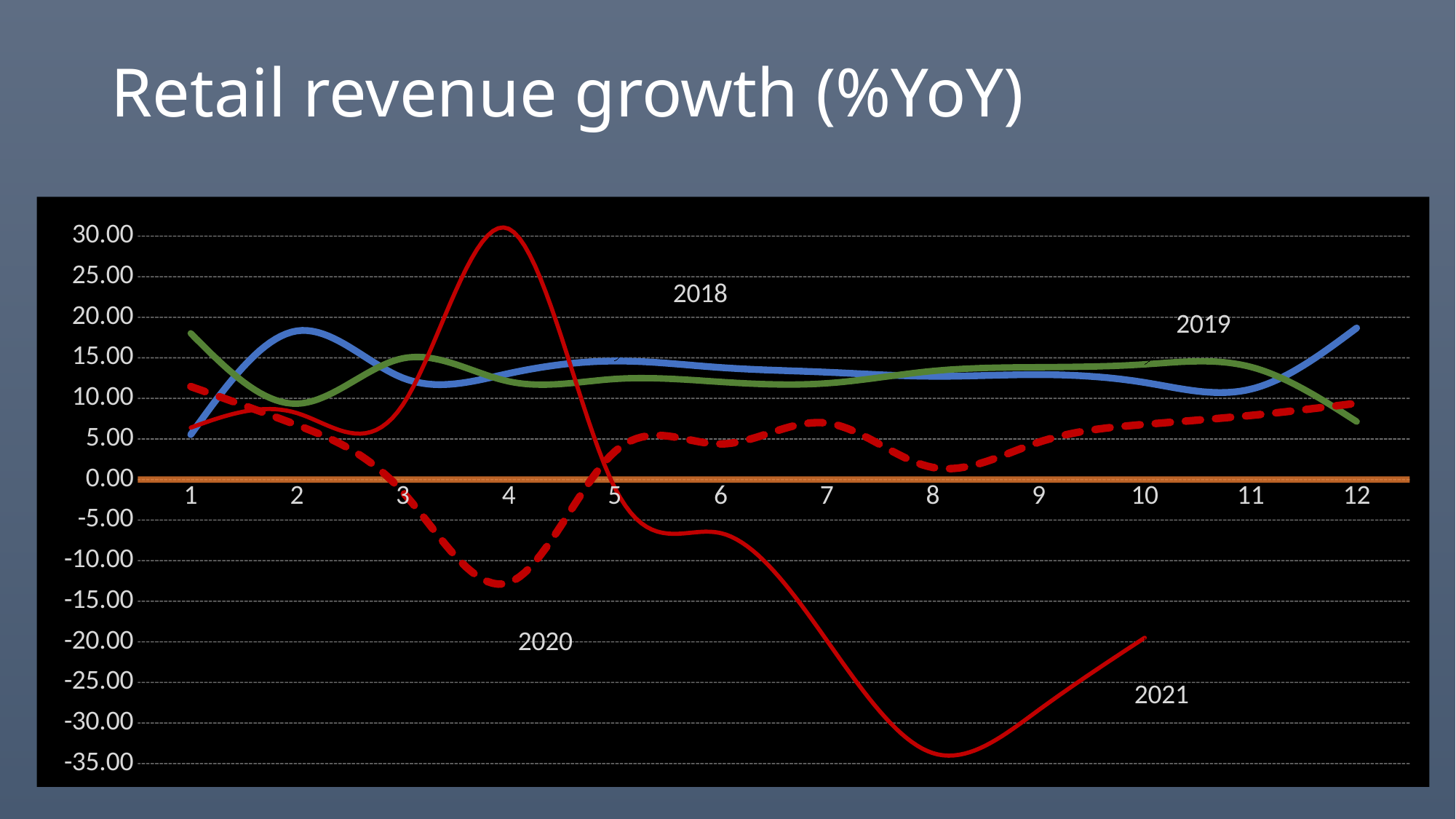
Which year's line is drawn as a dashed line? 2020 How many points are on the x axis of the chart? 12 At what value does the flat orange horizontal line sit? 0.00 What type of chart is shown on the slide? line chart At month 12, which is larger, the value for 2018 or the value for 2019? 2018 How many year series are labelled on the chart? 4 Which year's line reaches the highest value on the chart? 2021 Which year's line reaches the lowest value on the chart? 2021 Is the value for 2021 at month 8 greater or less than -30.00? less What is the title of the chart? Retail revenue growth (%YoY) Is the value for 2020 at month 4 greater or less than -10.00? less Does the 2021 line rise or fall from month 4 to month 8? fall